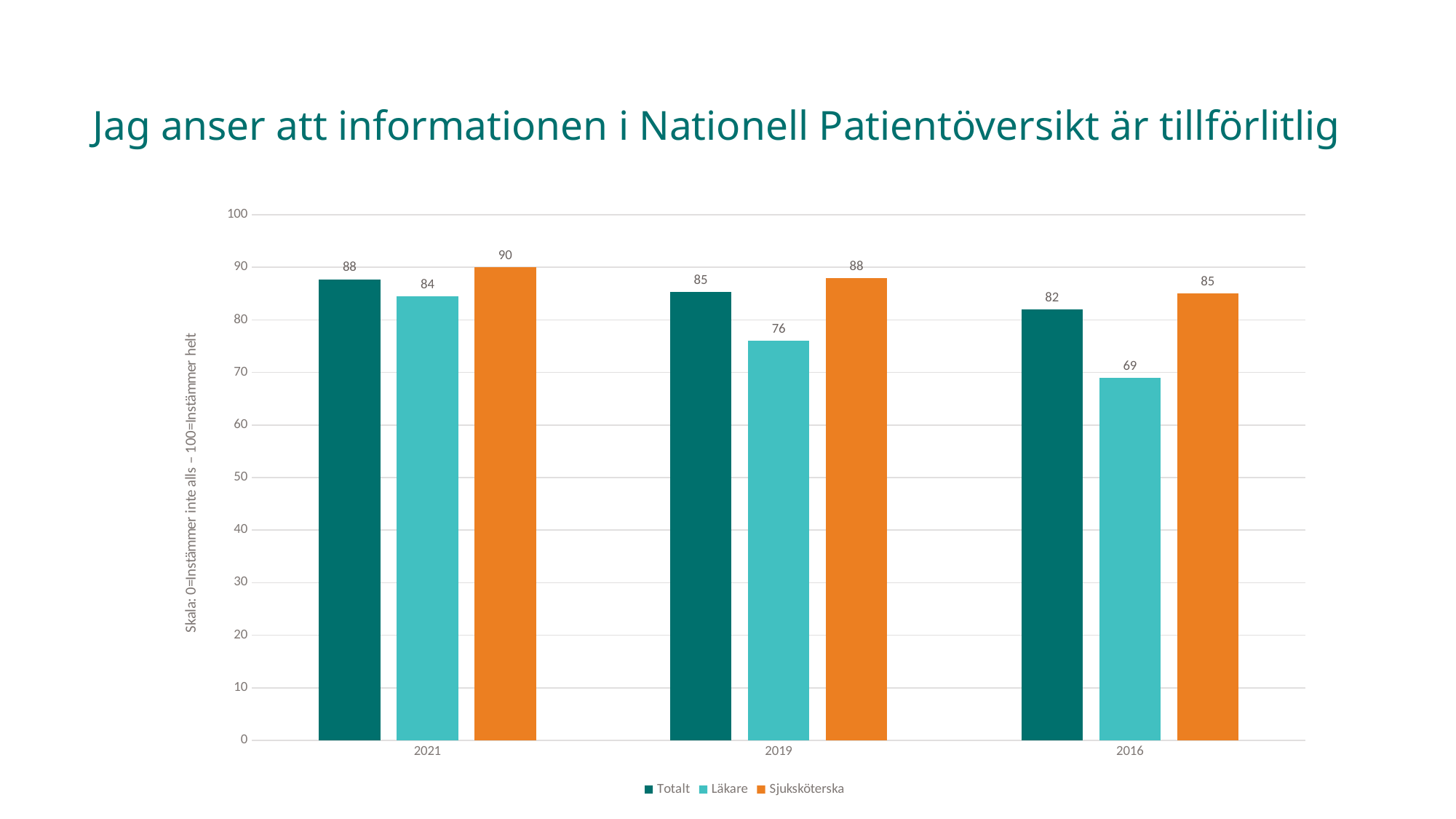
Which year has the highest value for Läkare? 2021 How many series does the legend list? 3 Which series is shown in orange in the legend? Sjuksköterska What kind of chart is shown on the slide? Bar chart Which year has the lowest value for Sjuksköterska? 2016 What is the value for Totalt in 2021? 88 What is the value for Läkare in 2016? 69 Is the value for Läkare in 2016 greater or less than 70? less What is the value for Sjuksköterska in 2019? 88 What is the difference between the Sjuksköterska and Läkare values in 2019? 12 How many years are shown on the x axis? 3 Which is larger in 2016: the value for Totalt or the value for Läkare? Totalt